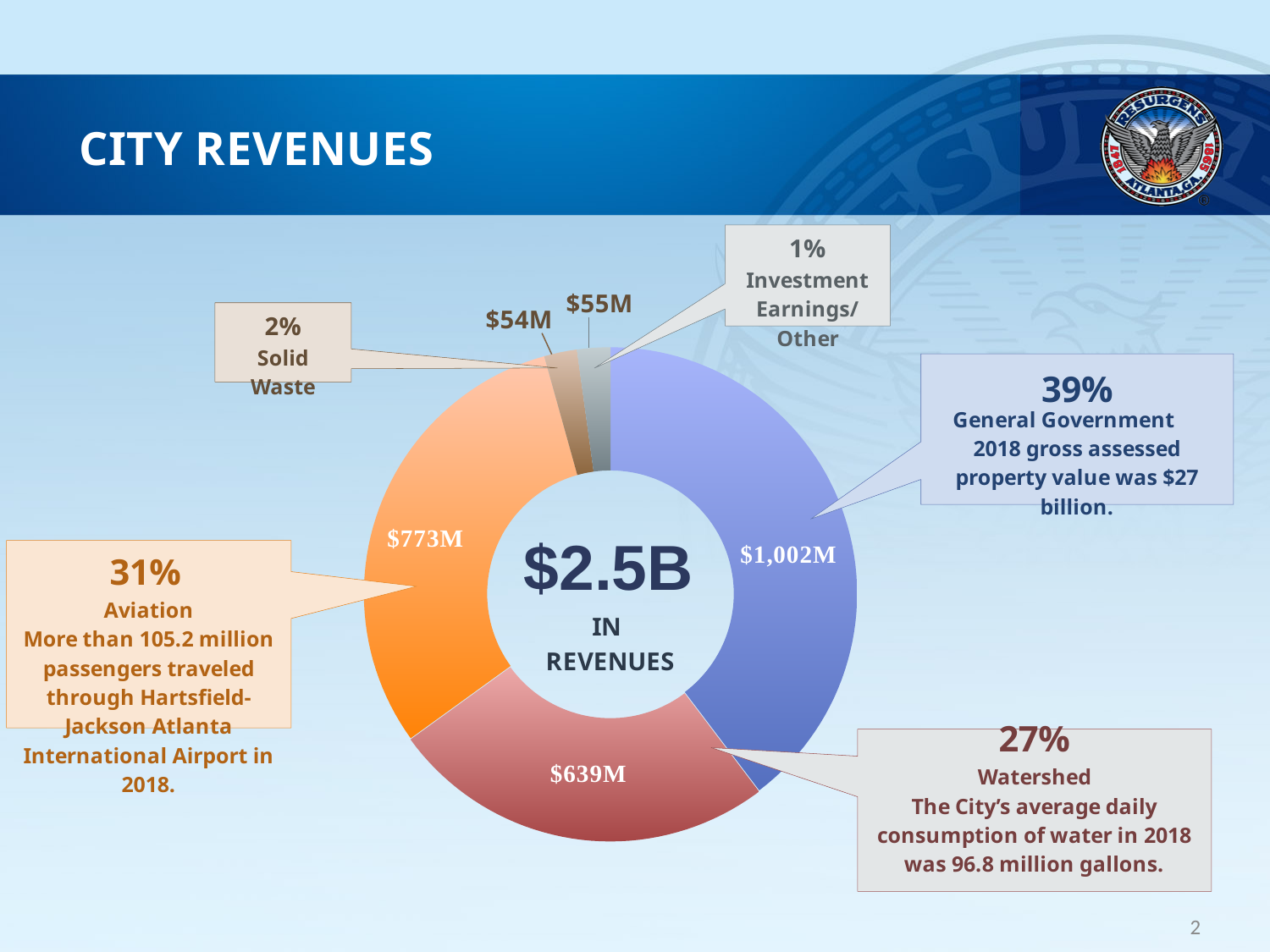
What is the revenue value shown for General Government? $1,002M What is the revenue value shown for Aviation? $773M What percentage share of revenues does General Government represent? 39% How many revenue categories are shown in the chart? 5 Which revenue category has the largest slice? General Government What total revenue figure is shown in the center of the chart? $2.5B What percentage share of revenues does Watershed represent? 27% What percentage share of revenues does Solid Waste represent? 2% What is the difference between the General Government revenue and the Aviation revenue? $229M Which is larger, the revenue for Aviation or the revenue for Watershed? Aviation What type of chart is shown on the slide? Pie chart (donut) What is the revenue value shown for Watershed? $639M